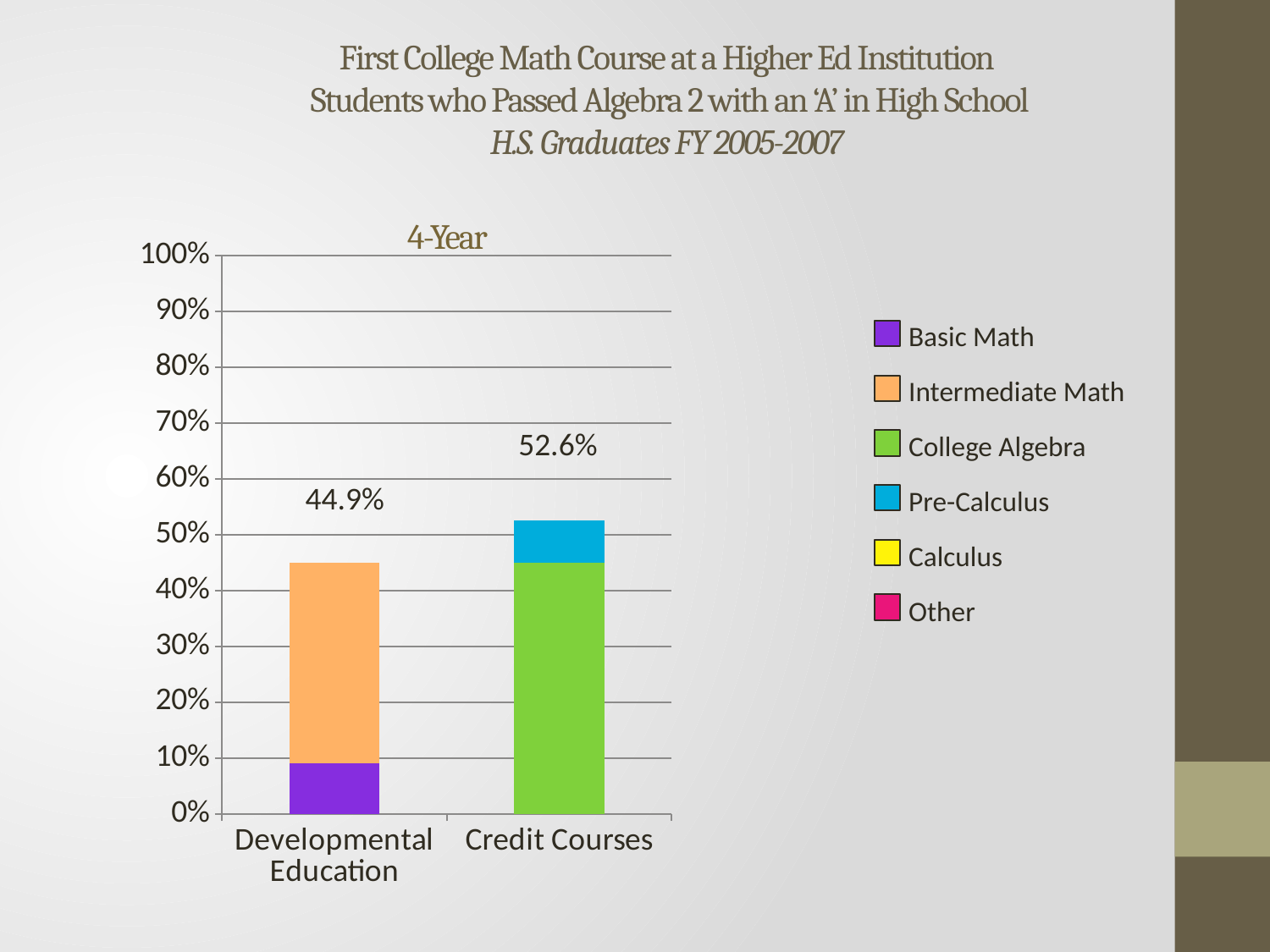
What is the total value shown for the Developmental Education bar? 44.9% Which category has the higher total, Developmental Education or Credit Courses? Credit Courses Is the Pre-Calculus segment of the Credit Courses bar greater or less than 20%? less What kind of chart is shown on the slide? Stacked bar chart What is the title shown above the chart? 4-Year How many series does the legend list? 6 How many categories are shown on the x axis? 2 Which legend entry is shown in green? College Algebra Is the Intermediate Math segment of the Developmental Education bar greater or less than 30%? greater What is the difference between the Credit Courses total and the Developmental Education total? 7.7% Is the College Algebra segment of the Credit Courses bar greater or less than 40%? greater What is the total value shown for the Credit Courses bar? 52.6%